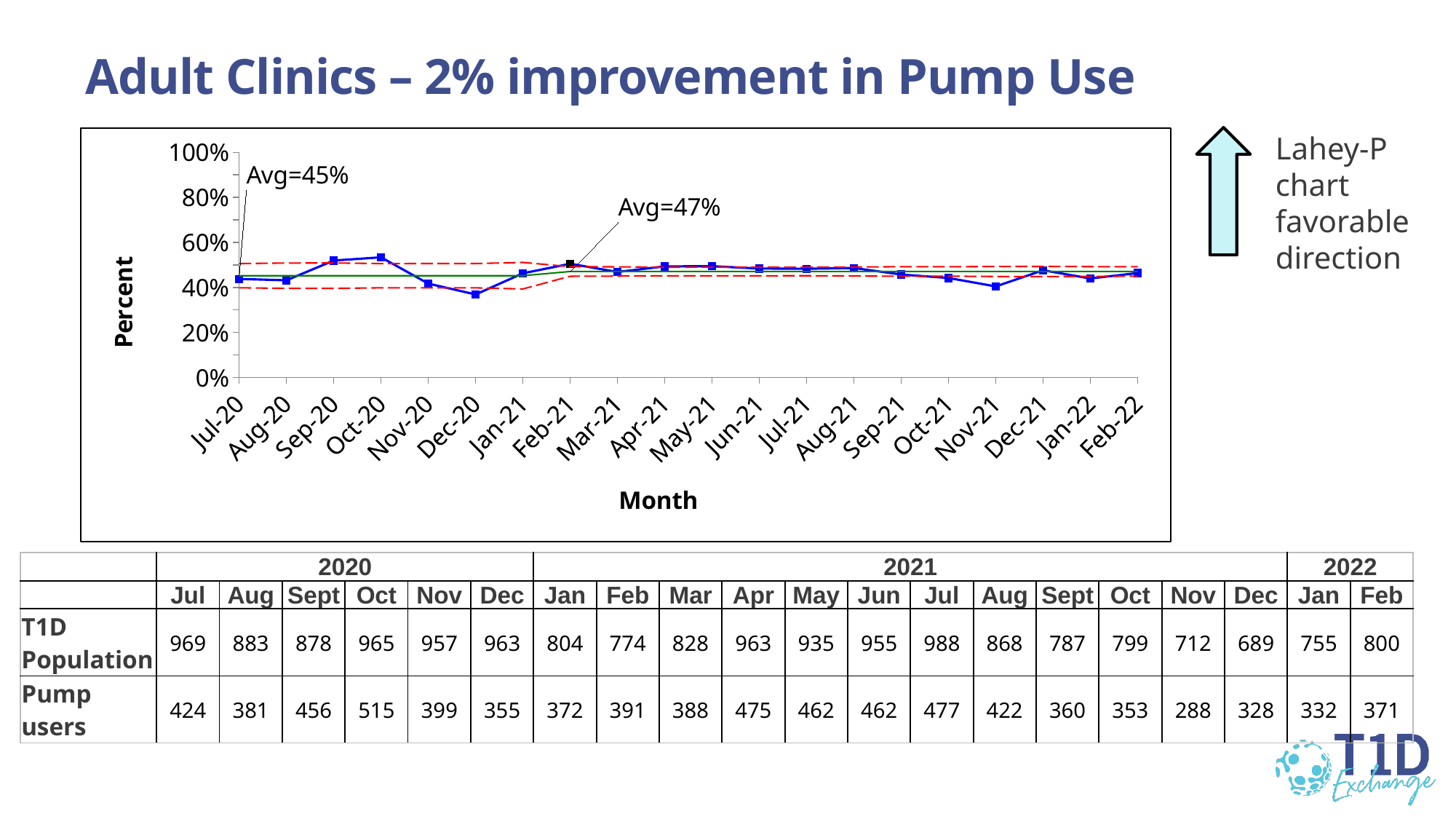
What kind of chart is shown on the slide? line chart What is the difference between the two annotated averages on the chart? 2% Which is larger, the value for Oct-20 or the value for Dec-20? Oct-20 What is the first month shown on the x axis of the chart? Jul-20 What is the title of the y axis of the chart? Percent What average value is annotated for the first period of the chart? Avg=45% Which month has the lowest plotted value on the chart? Dec-20 What average value is annotated for the second period of the chart, starting at Feb-21? Avg=47% Is the value for Oct-20 greater or less than 50%? greater How many months are plotted along the x axis of the chart? 20 Is the value for Dec-20 greater or less than 40%? less Is the value for Jul-20 greater or less than 60%? less